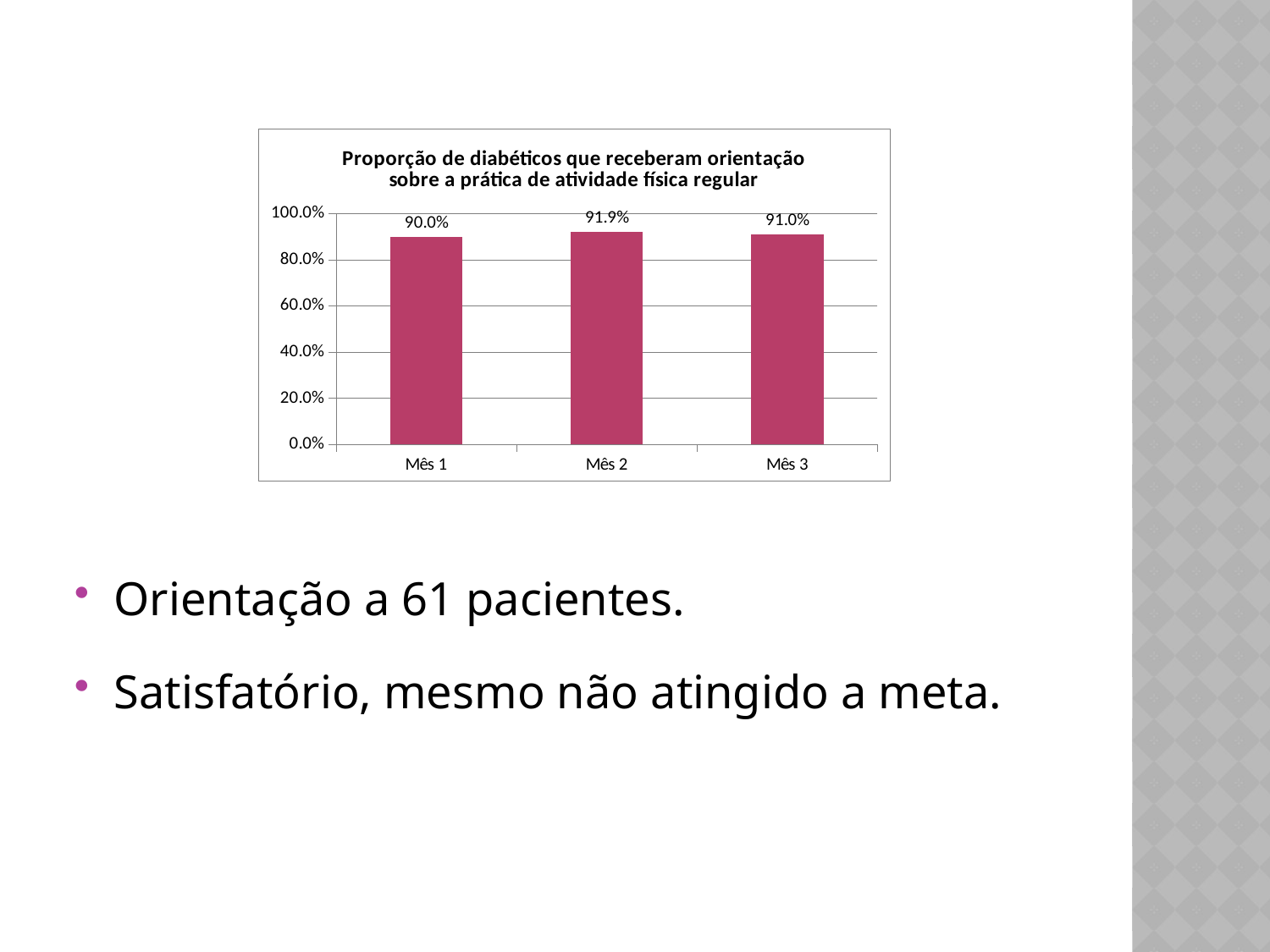
How many months are shown on the x axis? 3 What is the difference between the values for Mês 2 and Mês 1? 1.9% What is the value for Mês 1? 90.0% What is the value for Mês 2? 91.9% What kind of chart is shown on the slide? bar chart Which is larger, the value for Mês 2 or the value for Mês 3? Mês 2 Which month has the highest value? Mês 2 What is the title of the chart? Proporção de diabéticos que receberam orientação sobre a prática de atividade física regular What is the difference between the values for Mês 3 and Mês 1? 1.0% Which month has the lowest value? Mês 1 What is the value for Mês 3? 91.0% Is the value for Mês 1 greater or less than 80.0%? greater